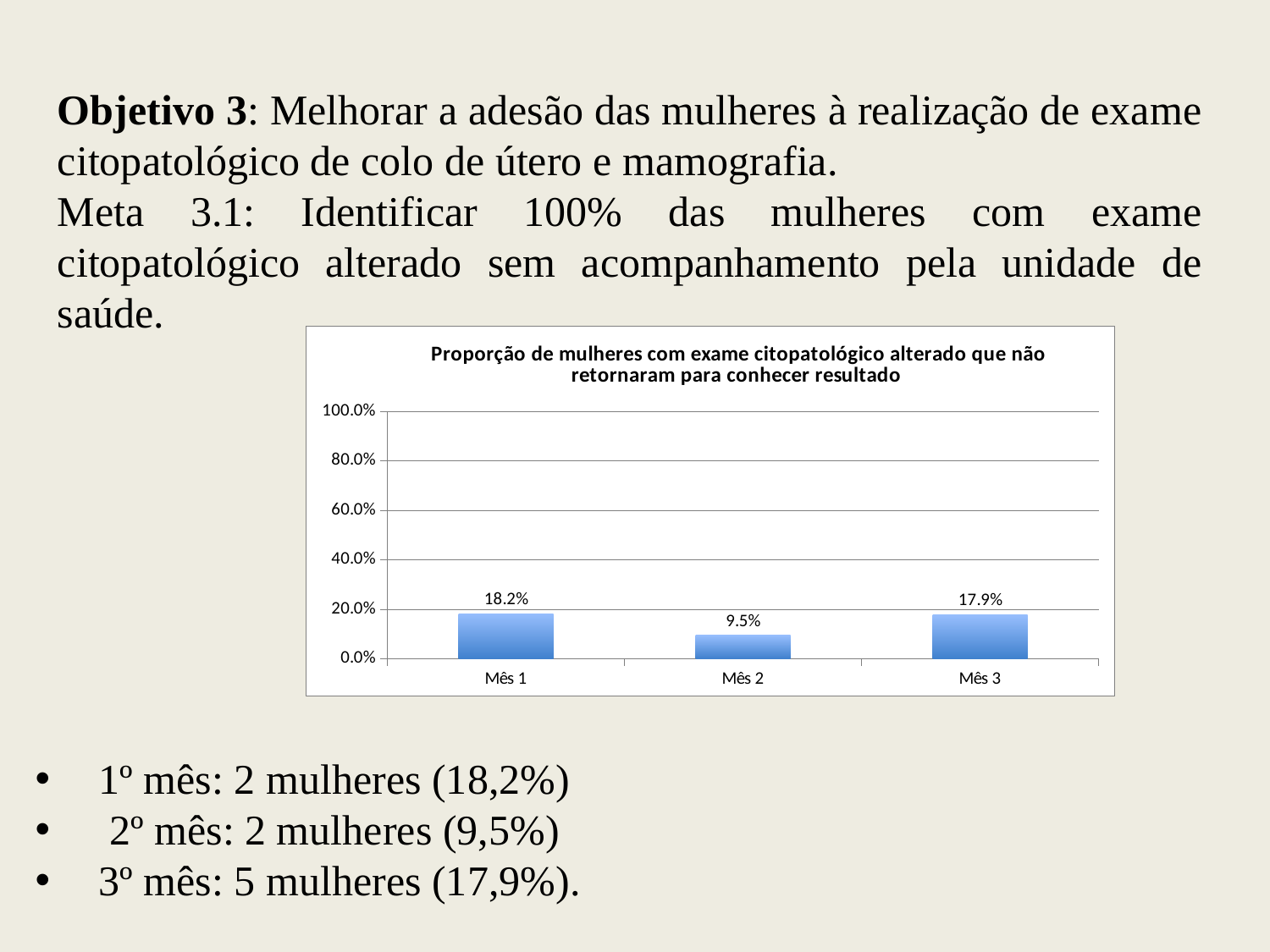
What is the difference between the values for Mês 3 and Mês 2? 8.4% Which is larger, the value for Mês 1 or the value for Mês 2? Mês 1 What is the highest value shown on the y axis? 100.0% What is the value for Mês 3? 17.9% What kind of chart is shown on the slide? bar chart Is the value for Mês 2 greater or less than 20.0%? less What is the value for Mês 2? 9.5% How many months are shown on the x axis? 3 Which month has the lowest value? Mês 2 What is the value for Mês 1? 18.2% What is the title of the chart? Proporção de mulheres com exame citopatológico alterado que não retornaram para conhecer resultado What is the difference between the values for Mês 1 and Mês 2? 8.7%